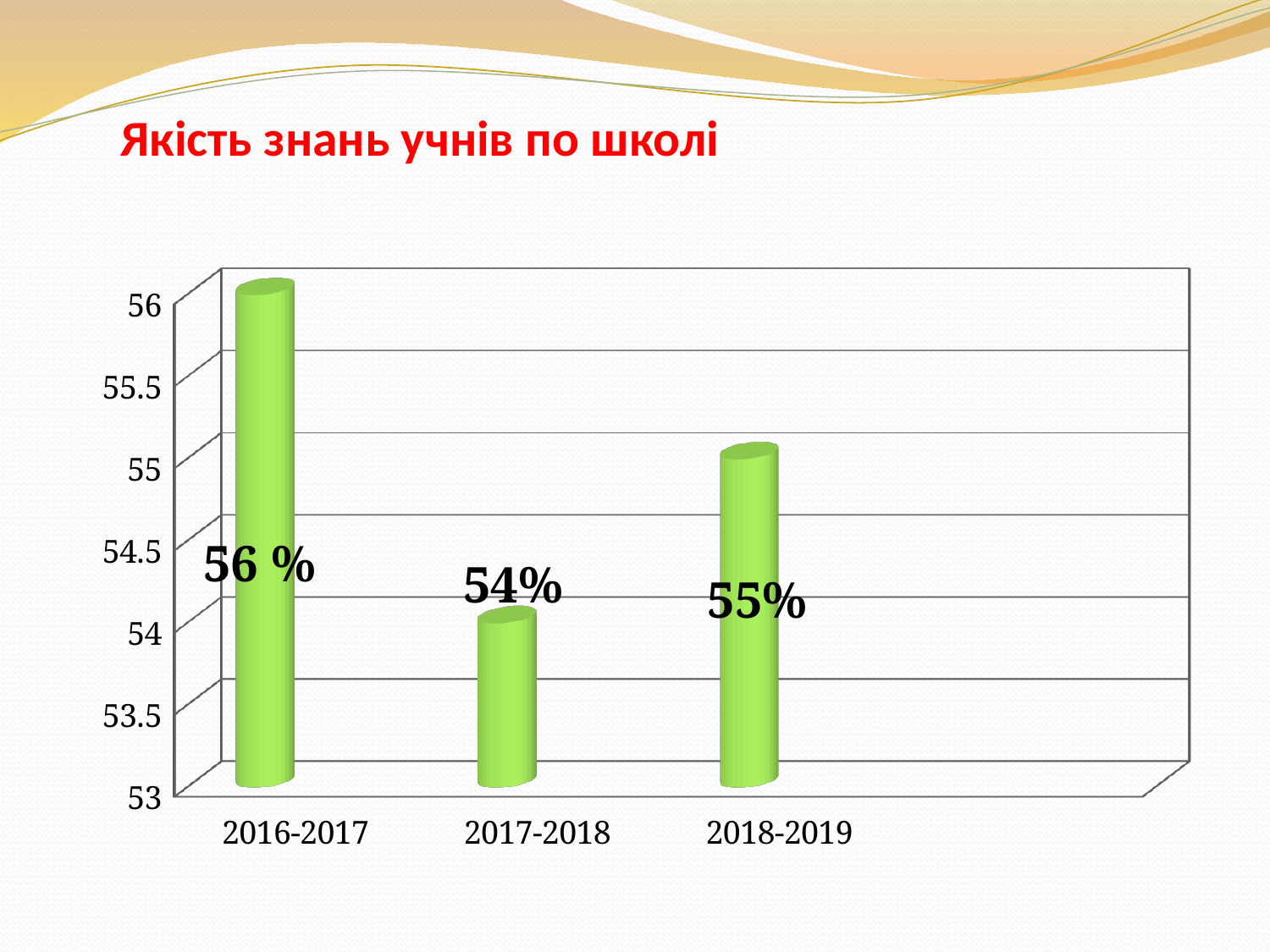
Which school year has the highest value? 2016-2017 Which is larger, the value for 2018-2019 or the value for 2017-2018? 2018-2019 How many school years are shown on the x axis? 3 What kind of chart is shown on the slide? bar chart What is the value for 2016-2017? 56 % What is the difference between the values for 2018-2019 and 2017-2018? 1% What is the title of the slide? Якість знань учнів по школі Which school year has the lowest value? 2017-2018 What is the value for 2017-2018? 54% Is the value for 2018-2019 greater or less than 54? greater What is the difference between the values for 2016-2017 and 2017-2018? 2% What is the value for 2018-2019? 55%